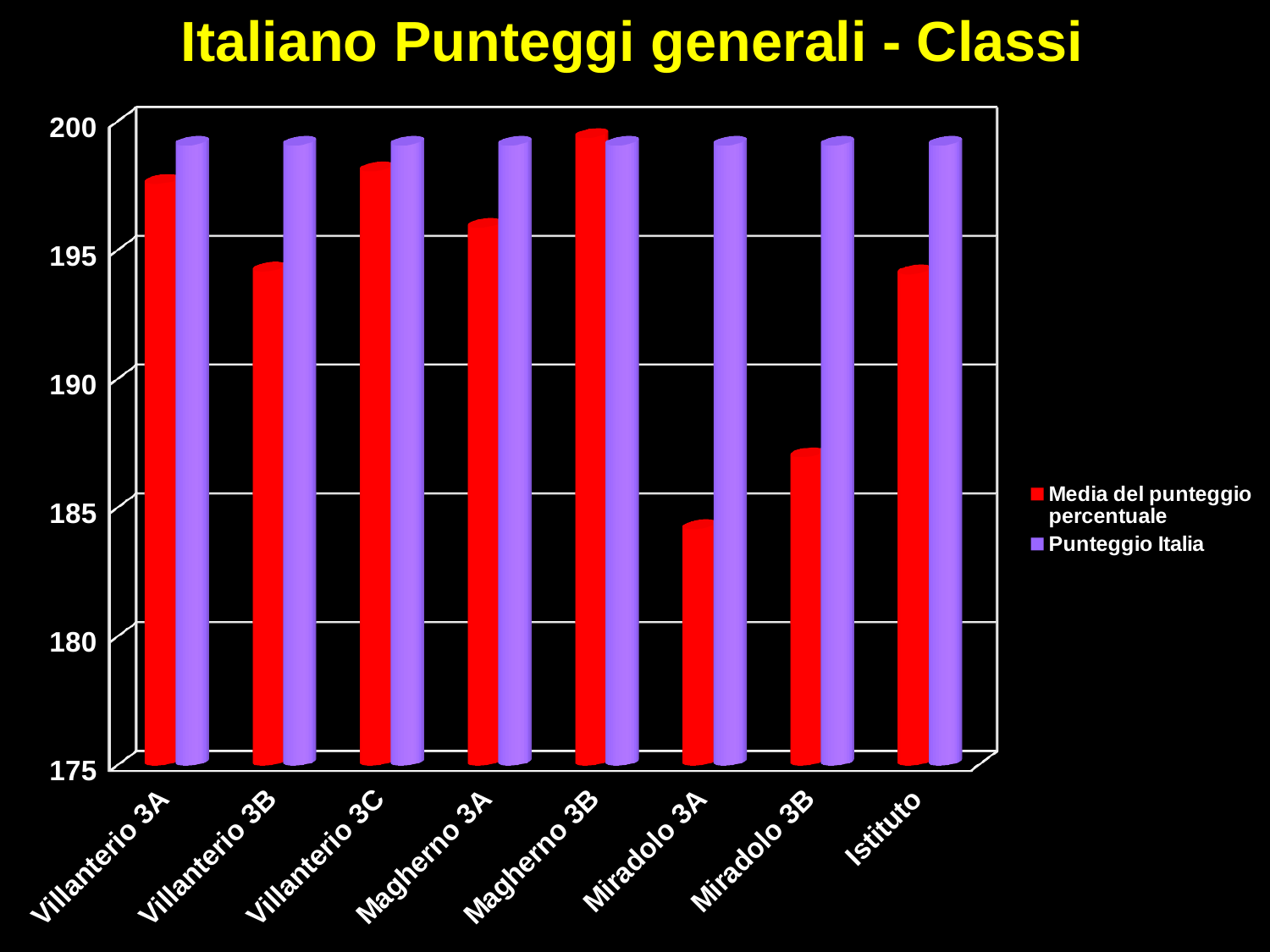
Is the Media del punteggio percentuale value for Magherno 3A greater or less than 195? greater Which category has the highest value for Media del punteggio percentuale? Magherno 3B Is the Media del punteggio percentuale value for Miradolo 3B greater or less than 185? greater Which series is shown in red in the chart? Media del punteggio percentuale Which category has the lowest value for Media del punteggio percentuale? Miradolo 3A Is the Media del punteggio percentuale value for Villanterio 3B greater or less than 195? less What kind of chart is shown on the slide? Bar chart How many series does the legend list? 2 Which has the larger Media del punteggio percentuale value, Villanterio 3A or Villanterio 3B? Villanterio 3A How many categories are shown on the x axis of the chart? 8 What is the title of the chart? Italiano Punteggi generali - Classi